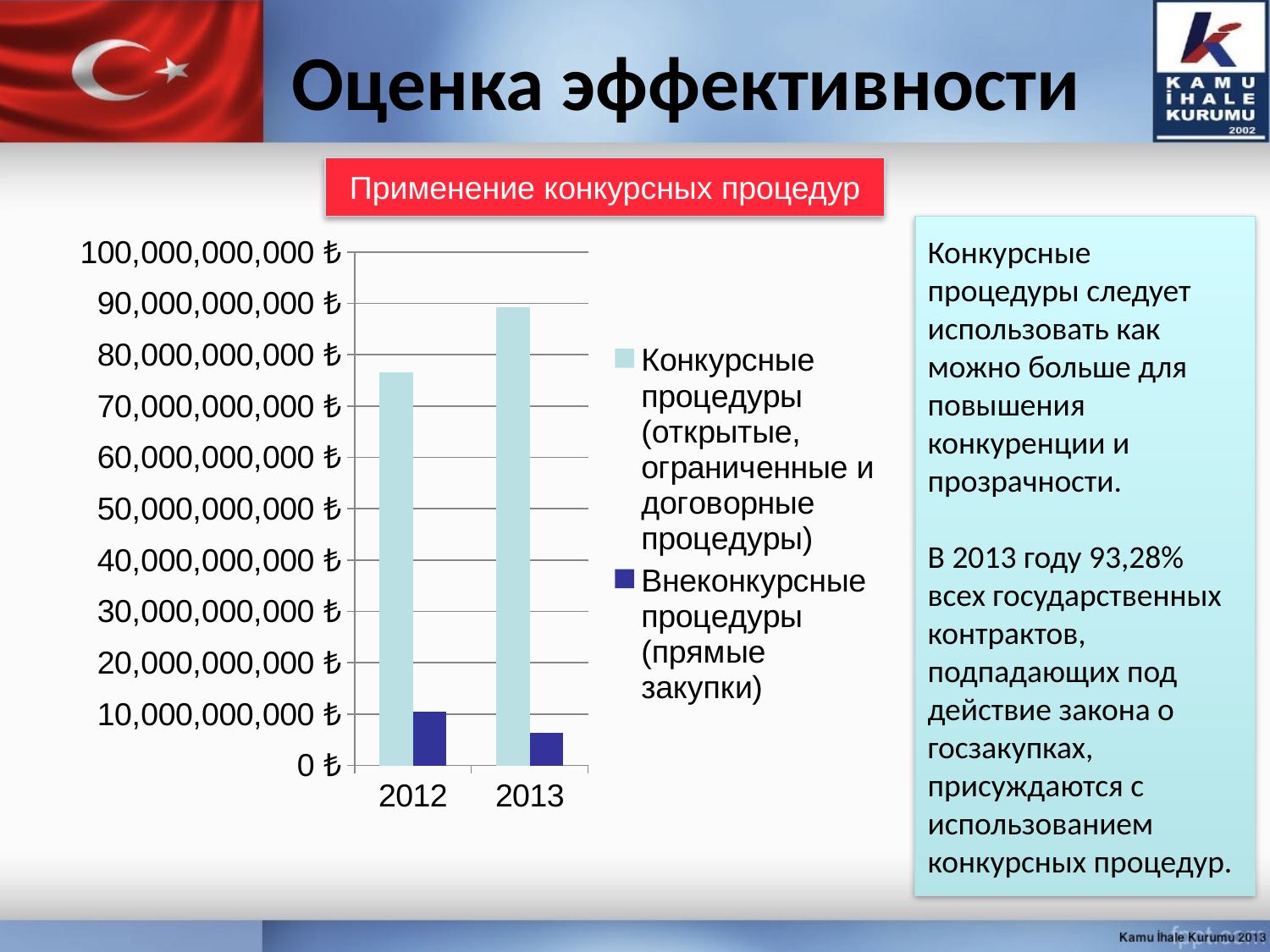
Is the value for Внеконкурсные процедуры in 2012 greater or less than 20,000,000,000 ₺? less Is the value for Конкурсные процедуры in 2013 greater or less than 80,000,000,000 ₺? greater What kind of chart is shown on the slide? bar chart Is the value for Конкурсные процедуры in 2012 greater or less than 80,000,000,000 ₺? less How many series does the chart legend list? 2 How many years are shown on the x axis of the chart? 2 Which year has the higher value for Конкурсные процедуры, 2012 or 2013? 2013 Do the values for Внеконкурсные процедуры rise or fall from 2012 to 2013? fall Which series is shown in light blue in the chart? Конкурсные процедуры What is the title of the chart? Применение конкурсных процедур